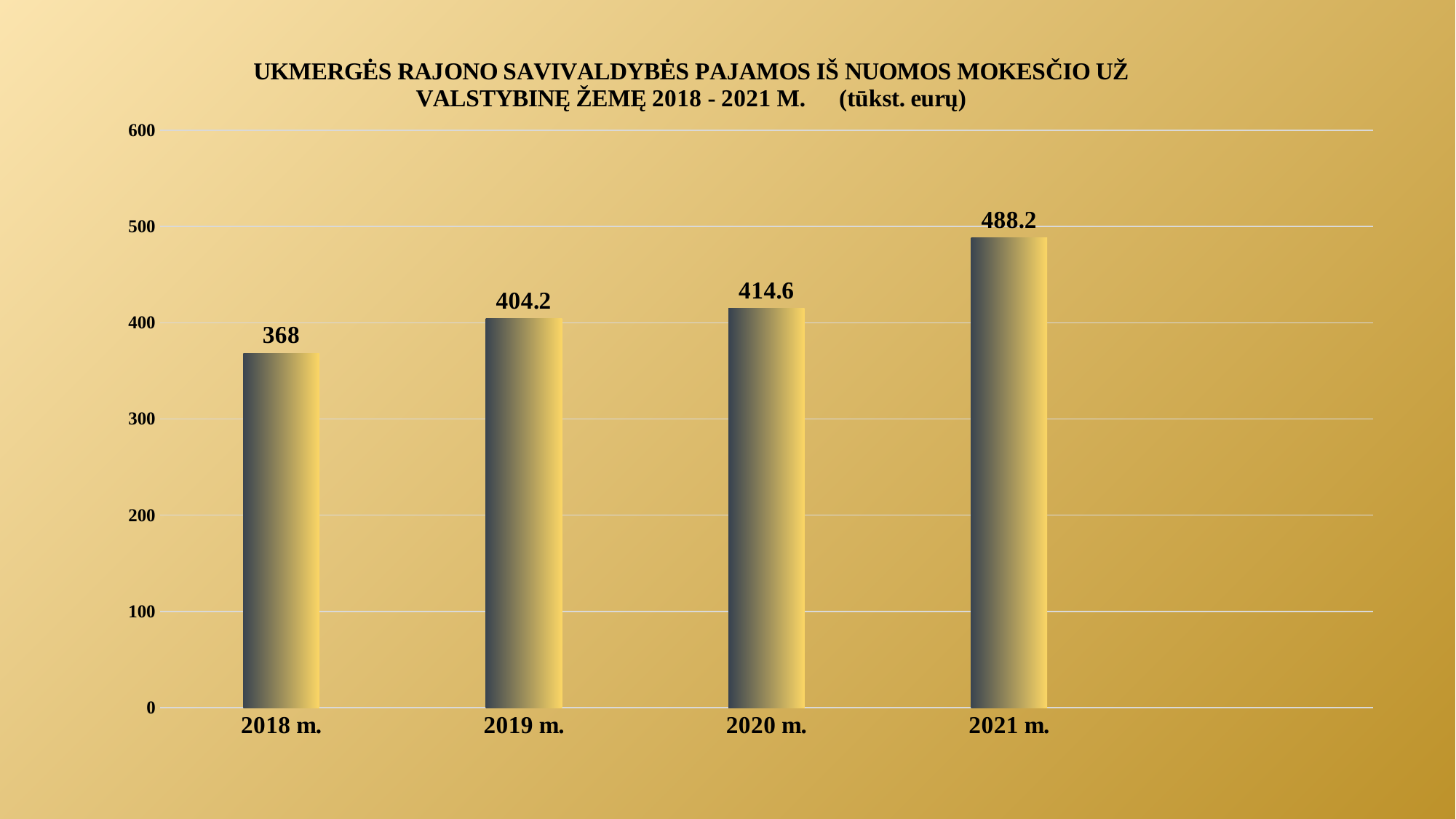
Which year has the highest value? 2021 m. Which is larger, the value for 2019 m. or the value for 2020 m.? 2020 m. What is the value for 2018 m.? 368 What is the value for 2021 m.? 488.2 What is the difference between the values for 2021 m. and 2018 m.? 120.2 What is the difference between the values for 2020 m. and 2019 m.? 10.4 Which year has the lowest value? 2018 m. Do the values rise or fall from 2018 m. to 2021 m.? Rise What is the value for 2019 m.? 404.2 What is the value for 2020 m.? 414.6 What kind of chart is shown on the slide? Bar chart How many years are shown on the chart? 4